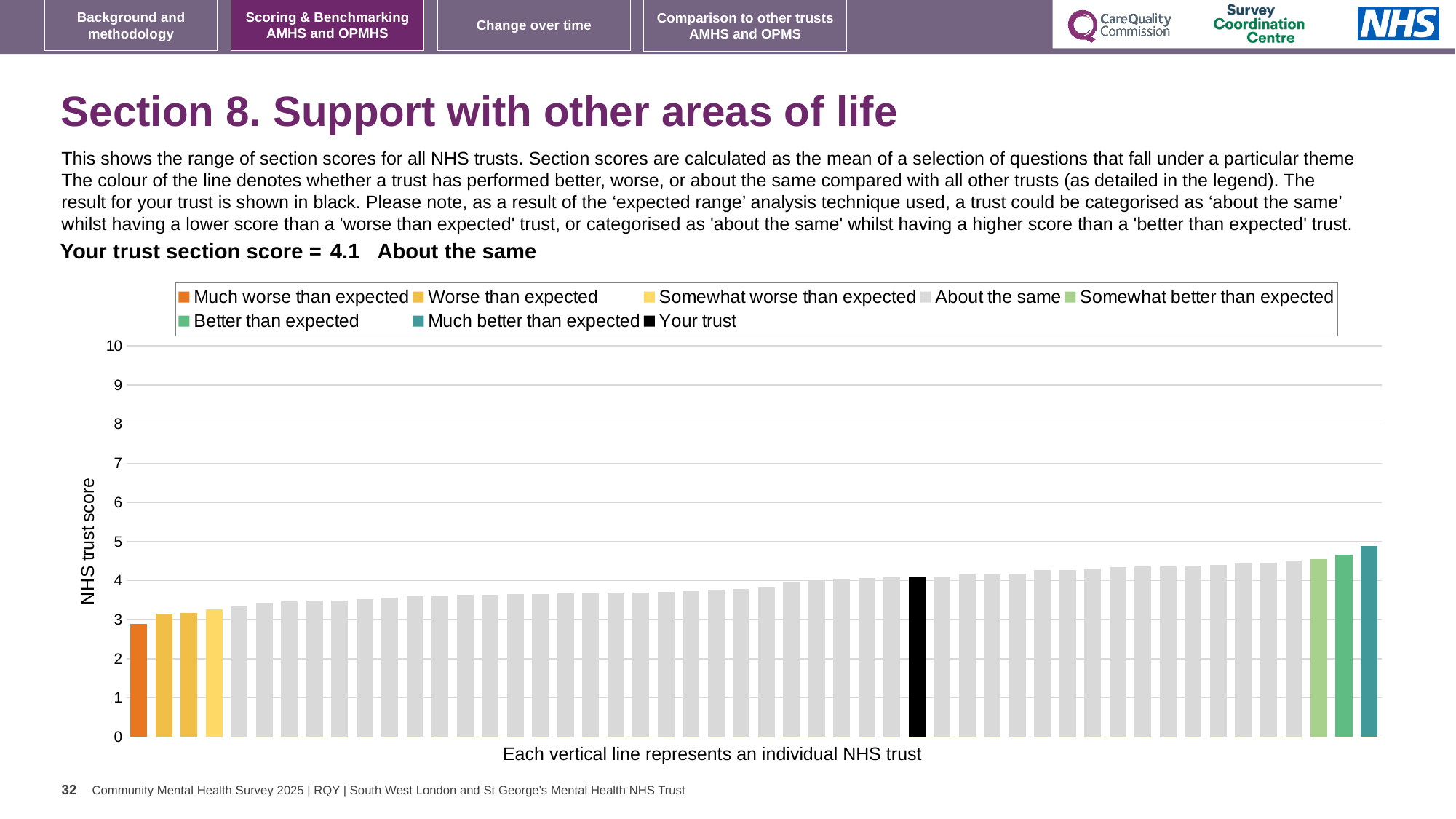
Is the value for the tallest bar greater or less than 4? greater Is the value for your trust greater or less than 5? less What is the label on the vertical axis of the chart? NHS trust score Which performance category is your trust placed in for this section? About the same What colour is the bar representing your trust? black Do the bar values rise or fall from left to right along the x axis? rise How many entries does the chart legend list? 8 Is your trust's bar higher or lower than the orange 'Much worse than expected' bar? higher Is the value for the shortest bar greater or less than 4? less What kind of chart is shown on the slide? bar chart What is the section score for your trust? 4.1